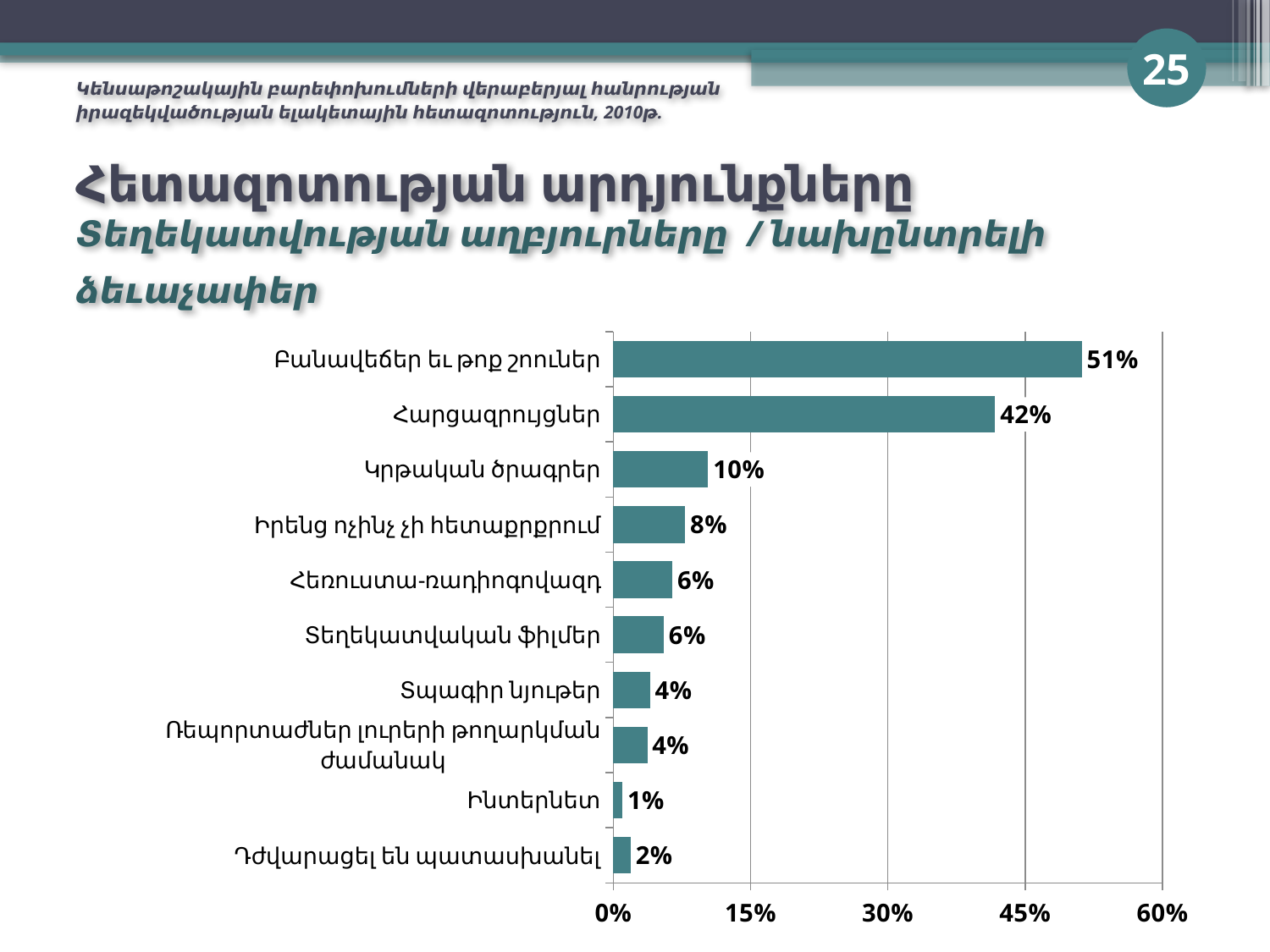
How many categories are shown in the chart? 10 What kind of chart is shown on the slide? bar chart What is the difference between the values for Բանավեճեր եւ թոք շոուներ and Հարցազրույցներ? 9% Is the value for Հարցազրույցներ greater or less than 30%? greater What is the value for Հարցազրույցներ? 42% Which category has the highest value? Բանավեճեր եւ թոք շոուներ Which category has the lowest value? Ինտերնետ What is the value for Բանավեճեր եւ թոք շոուներ? 51% What is the value for Ինտերնետ? 1% What is the value for Դժվարացել են պատասխանել? 2% Which is larger, the value for Կրթական ծրագրեր or the value for Իրենց ոչինչ չի հետաքրքրում? Կրթական ծրագրեր What is the value for Կրթական ծրագրեր? 10%